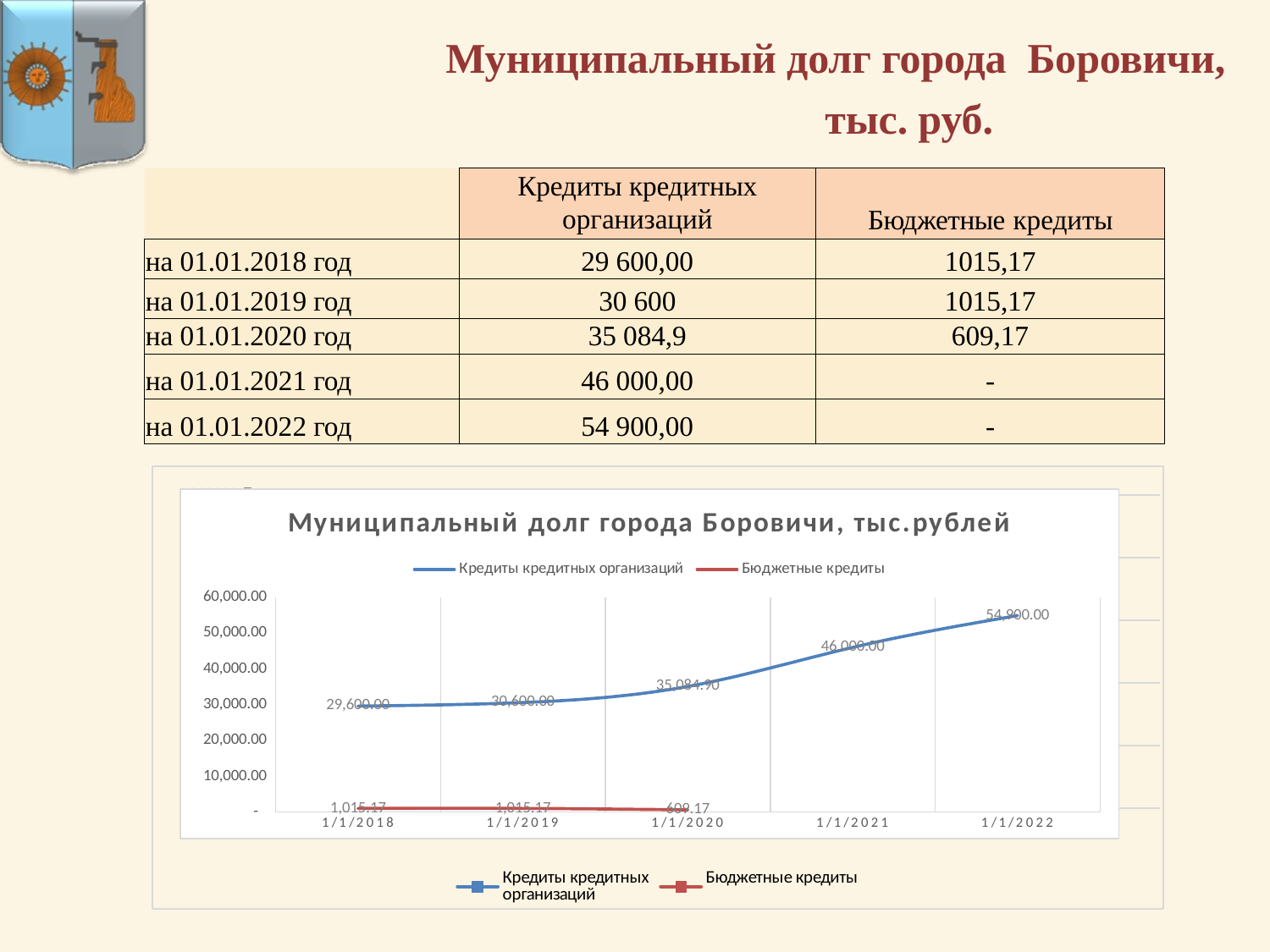
What is the value of Кредиты кредитных организаций at 1/1/2022 in the chart? 54,900.00 What is the value of Кредиты кредитных организаций at 1/1/2020 in the chart? 35,084.90 What type of chart is shown on the slide? line chart What is the value of Бюджетные кредиты at 1/1/2020 in the chart? 609.17 At which date is Кредиты кредитных организаций lowest in the chart? 1/1/2018 At which date does Кредиты кредитных организаций reach its highest value in the chart? 1/1/2022 What is the title of the chart? Муниципальный долг города Боровичи, тыс.рублей What is the difference between the Кредиты кредитных организаций values at 1/1/2022 and 1/1/2021? 8,900.00 What is the value of Бюджетные кредиты at 1/1/2018 in the chart? 1,015.17 How many series does the chart legend list? 2 Does the Кредиты кредитных организаций series rise or fall from 1/1/2018 to 1/1/2022? rise Which is larger in the chart: Кредиты кредитных организаций at 1/1/2021 or at 1/1/2020? 1/1/2021